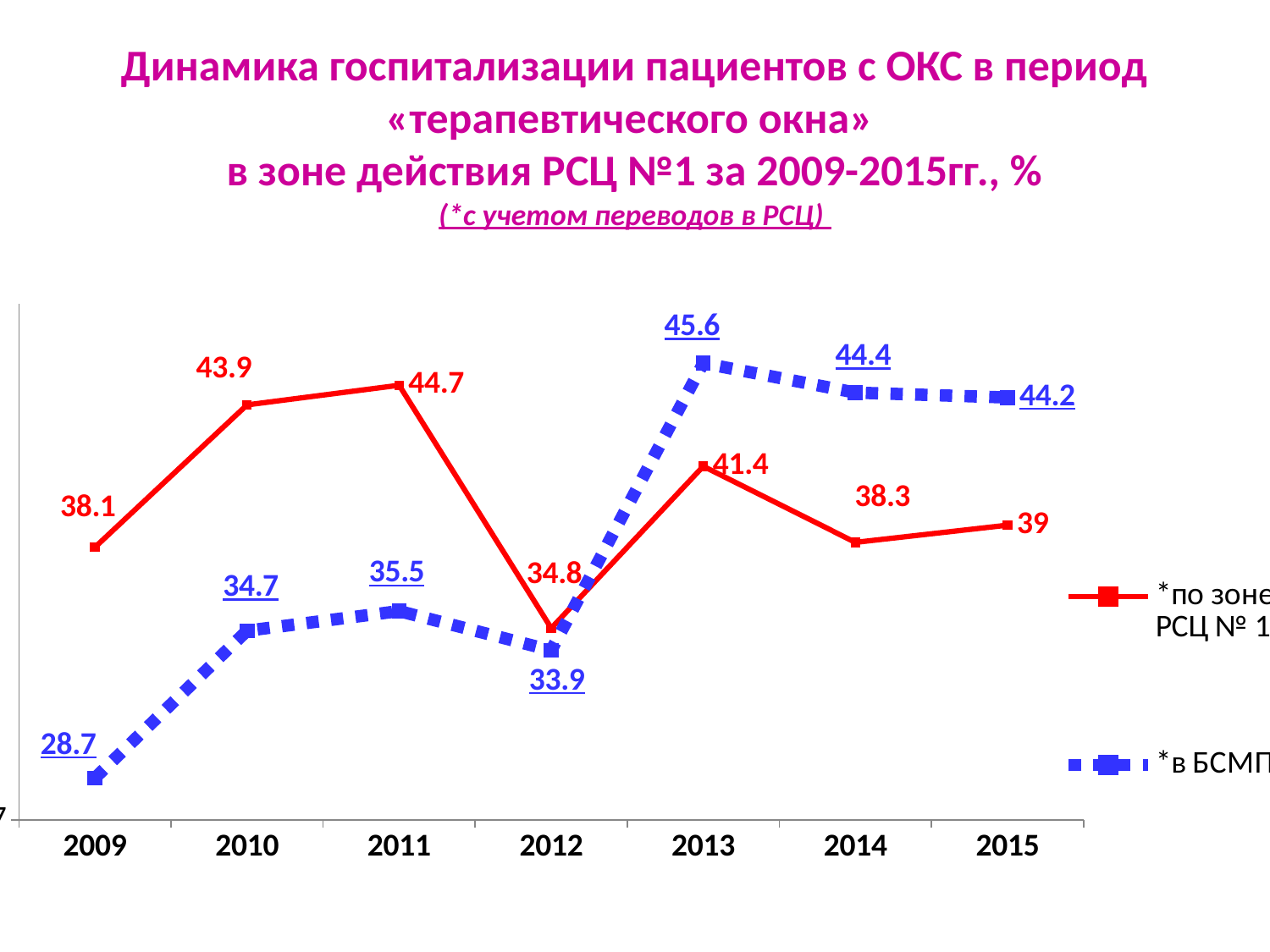
How many series does the legend list? 2 What is the difference between the red solid line and the blue dotted line in 2010? 9.2 What is the value of the red solid line (по зоне РСЦ № 1) in 2011? 44.7 What is the value of the blue dotted line (в БСМП) in 2013? 45.6 What is the value of the blue dotted line (в БСМП) in 2009? 28.7 In which year does the blue dotted line (в БСМП) reach its highest value? 2013 How many years are plotted along the x axis? 7 What line style is used for the в БСМП series? blue dotted line Which series has the larger value in 2014, the red solid line or the blue dotted line? the blue dotted line (в БСМП) Does the blue dotted line (в БСМП) rise or fall from 2013 to 2015? fall In which year does the red solid line (по зоне РСЦ № 1) reach its lowest value? 2012 What type of chart is shown on the slide? line chart